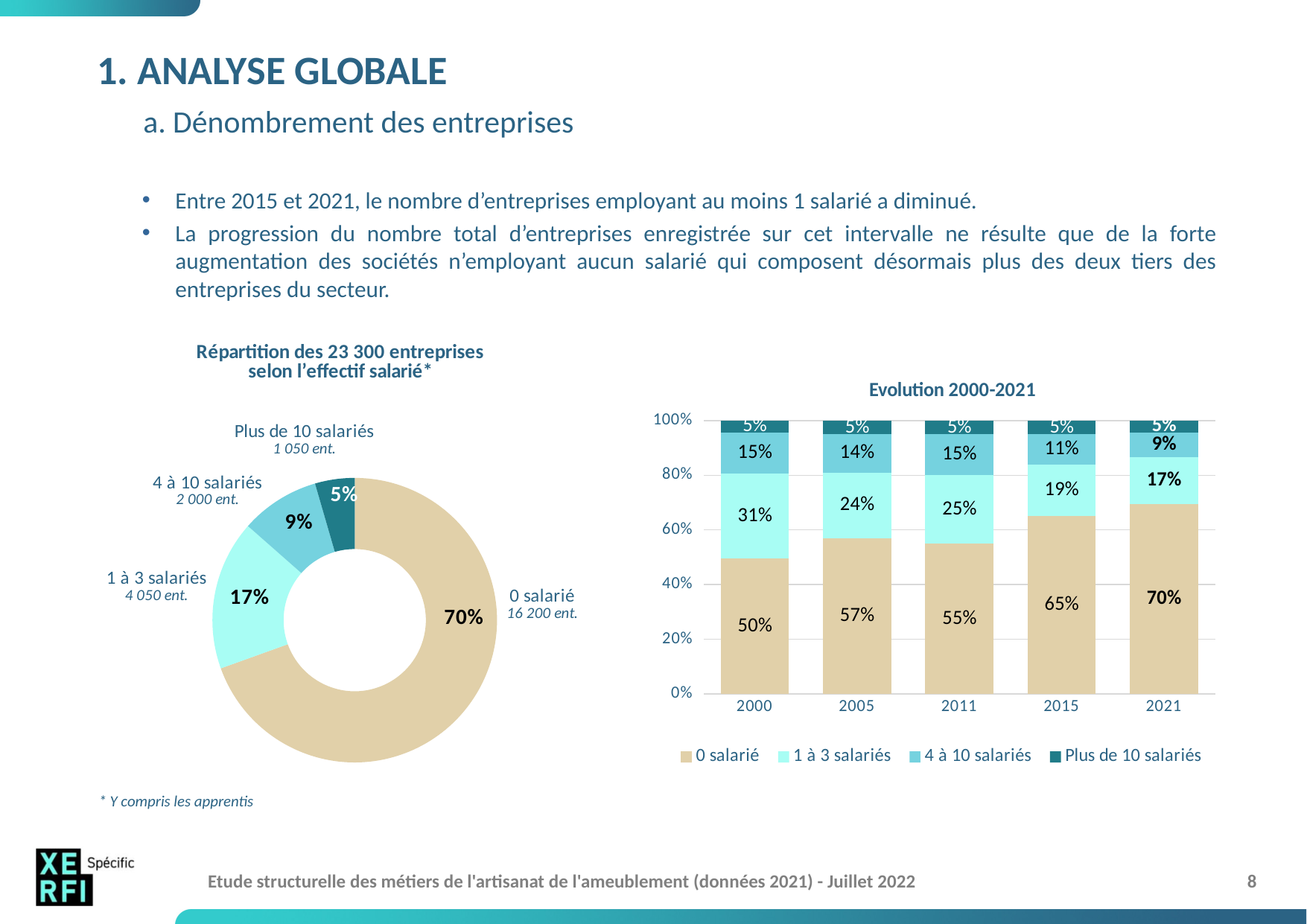
What kind of chart is the 'Répartition des 23 300 entreprises selon l'effectif salarié' chart? Doughnut (pie) chart How many series does the legend of the 'Evolution 2000-2021' chart list? 4 In the 'Répartition des 23 300 entreprises selon l'effectif salarié' chart, which category has the smallest share? Plus de 10 salariés In the 'Répartition des 23 300 entreprises selon l'effectif salarié' chart, how many categories are shown? 4 In the 'Evolution 2000-2021' chart, what is the difference between the '0 salarié' share in 2021 and in 2000? 20 percentage points In the 'Répartition des 23 300 entreprises selon l'effectif salarié' chart, what share of enterprises have 0 salarié? 70% In the 'Evolution 2000-2021' chart, which year has the highest share of '0 salarié'? 2021 In the 'Evolution 2000-2021' chart, is the '4 à 10 salariés' share larger in 2011 or in 2021? 2011 In the 'Evolution 2000-2021' chart, what is the value for '1 à 3 salariés' in 2000? 31% In the 'Evolution 2000-2021' chart, what is the value for '0 salarié' in 2005? 57% In the 'Evolution 2000-2021' chart, does the share of '1 à 3 salariés' rise or fall from 2000 to 2021? Fall In the 'Répartition des 23 300 entreprises selon l'effectif salarié' chart, how many enterprises are in the '1 à 3 salariés' category? 4 050 ent.